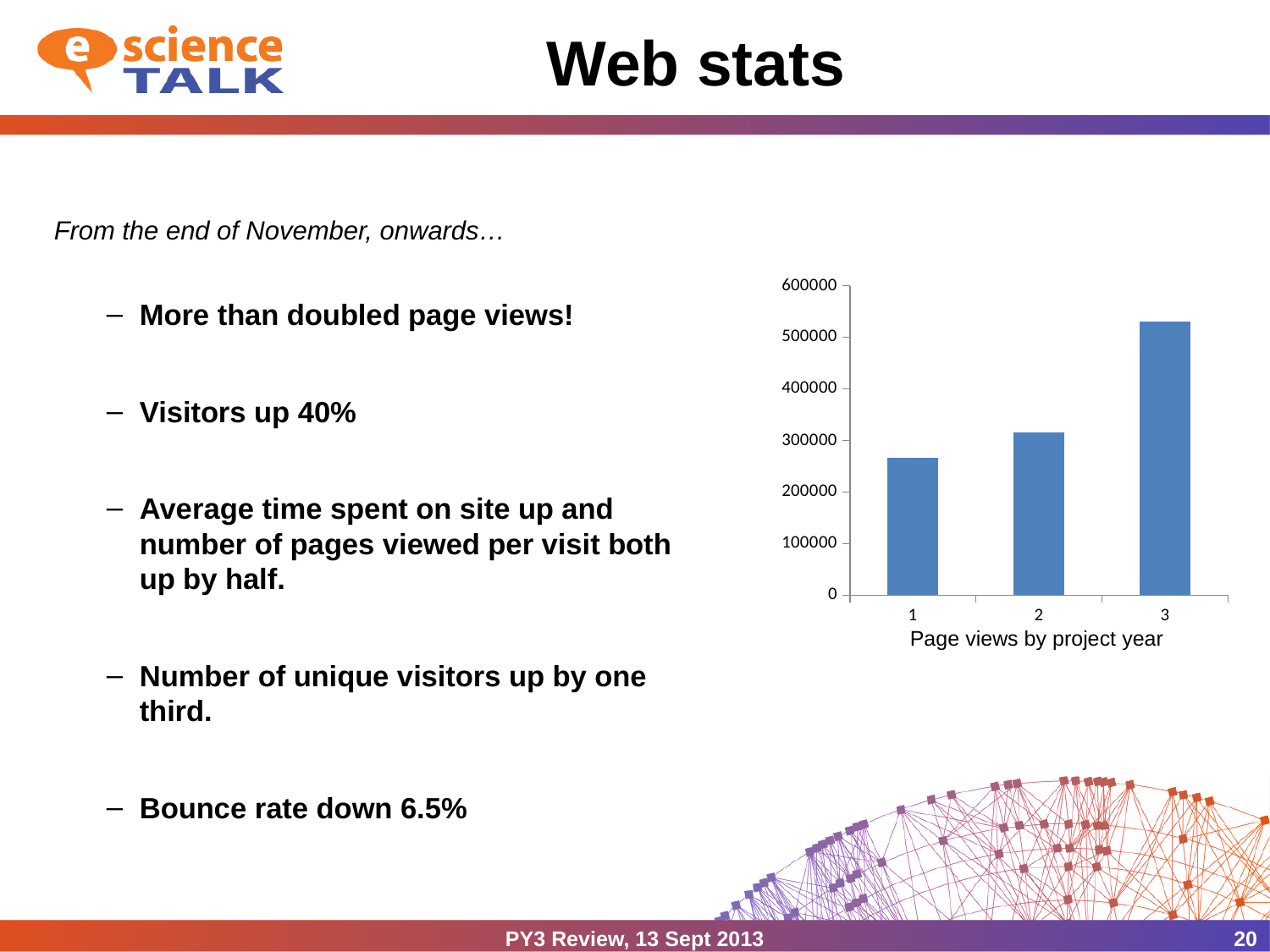
How many bars does the chart show? 3 Is the value for project year 3 greater or less than 500000? greater What kind of chart is shown on the slide? bar chart Is the value for project year 1 greater or less than 300000? less Is the value for project year 3 greater or less than 600000? less Which project year has the highest page views in the chart? 3 What is the label shown beneath the x axis of the chart? Page views by project year Which project year has the lowest page views in the chart? 1 Do the page views rise or fall from project year 1 to project year 3? rise Which has more page views, project year 2 or project year 3? 3